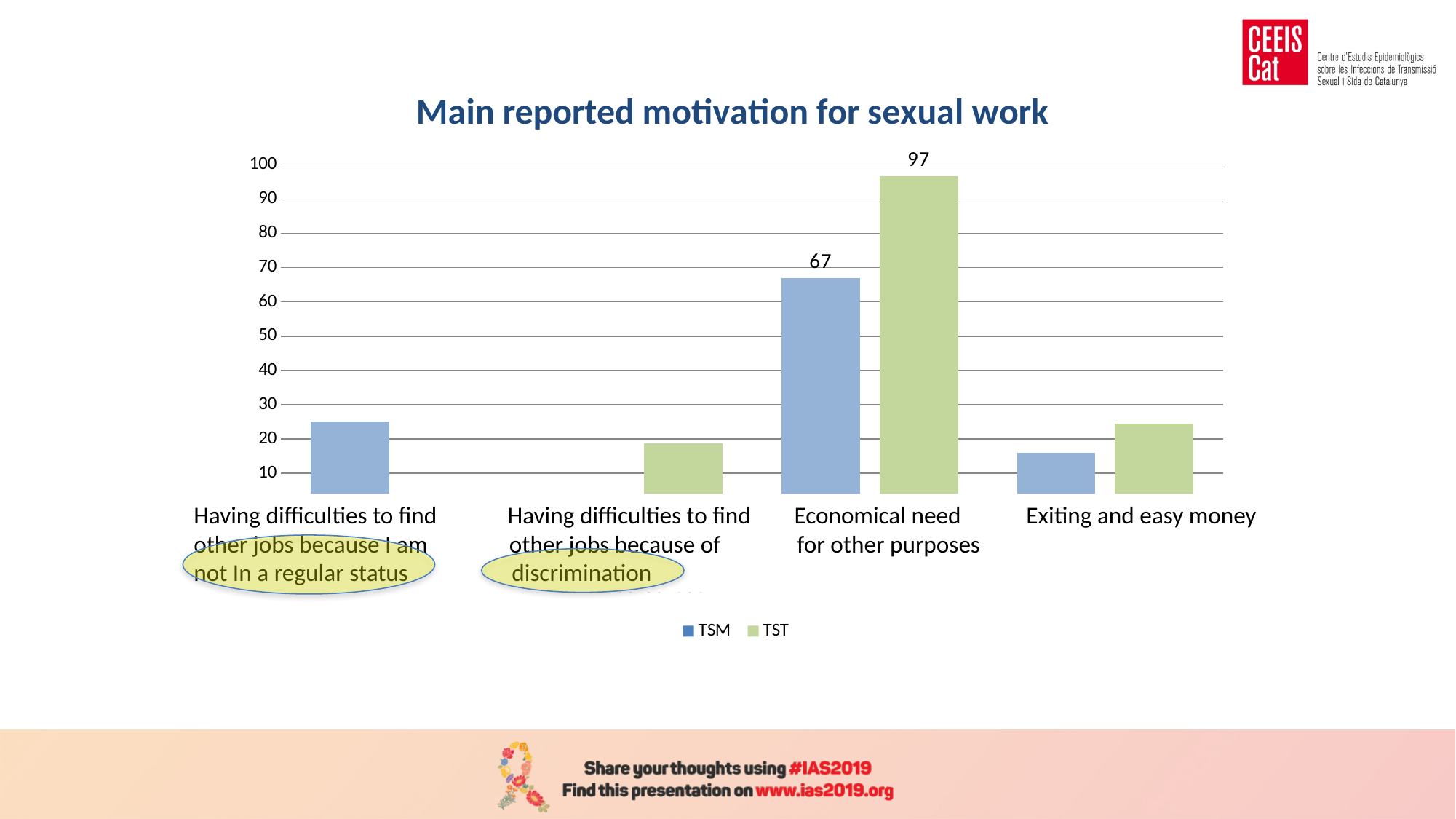
What is the difference between the TST and TSM values for "Economical need for other purposes"? 30 How many series does the legend list? 2 What is the title of the chart? Main reported motivation for sexual work Which colour represents the TST series in the legend? Green For "Economical need for other purposes", which series has the larger value, TSM or TST? TST Which category has the highest bar in the chart? Economical need for other purposes What is the TSM value for "Economical need for other purposes"? 67 How many categories are shown on the x axis? 4 Is the TSM value for "Having difficulties to find other jobs because I am not in a regular status" greater or less than 30? less What is the TST value for "Economical need for other purposes"? 97 Is the TSM value for "Exiting and easy money" greater or less than 20? less What kind of chart is shown on the slide? Bar chart